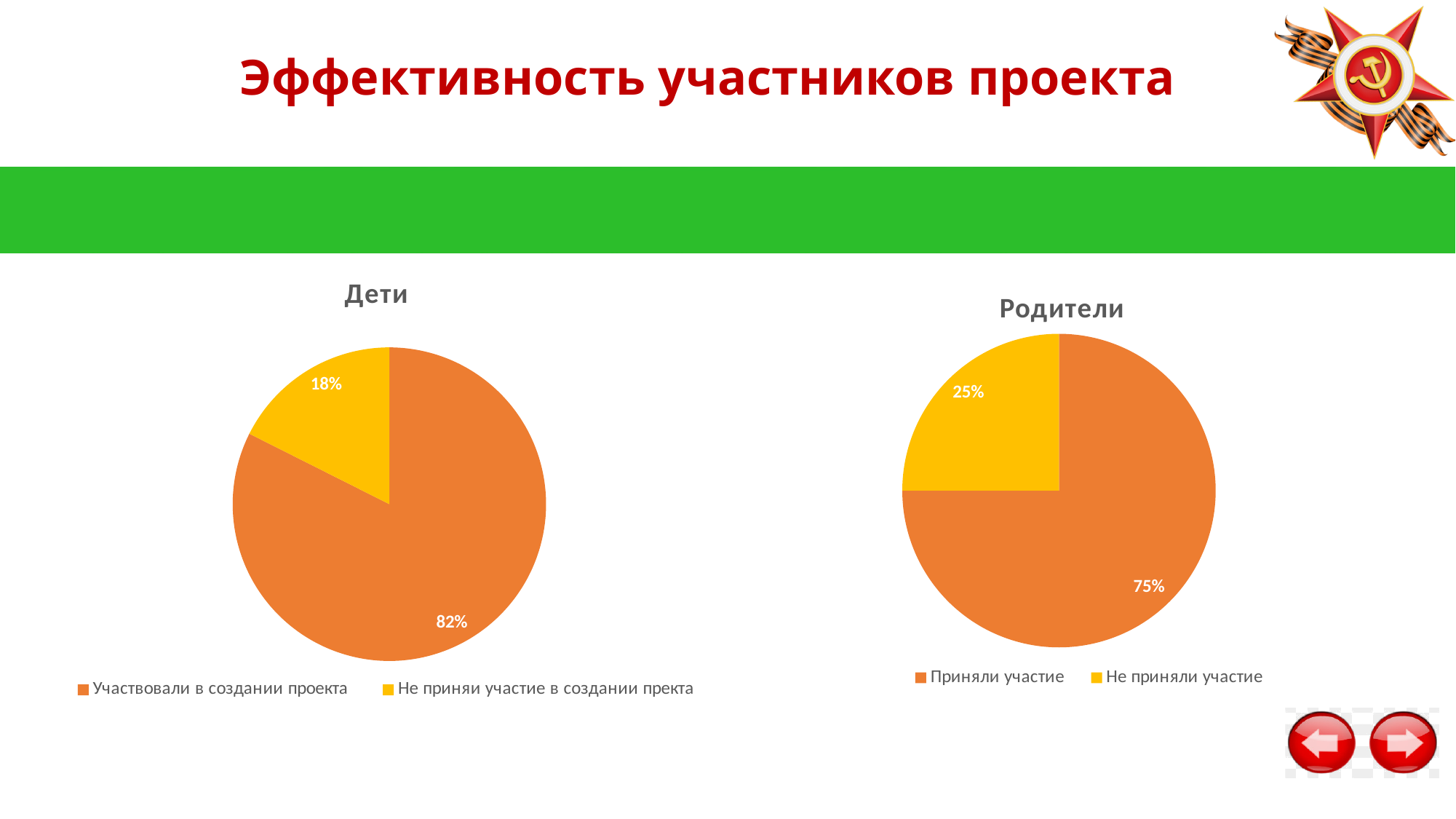
Which is larger: the 'Не приняи участие' slice in the 'Дети' chart or the 'Не приняли участие' slice in the 'Родители' chart? Родители (25%) In the 'Родители' chart, what share is labelled for 'Не приняли участие'? 25% In the 'Дети' chart, what share is labelled for 'Участвовали в создании проекта'? 82% How many entries does the legend of the 'Родители' chart list? 2 How many slices does the 'Дети' chart have? 2 In the 'Дети' chart, which slice is the largest? Участвовали в создании проекта In the 'Родители' chart, which slice is the smallest? Не приняли участие What type of chart is the 'Родители' chart? Pie chart In the 'Дети' chart, what share is labelled for 'Не приняи участие в создании пректа'? 18% In the 'Родители' chart, what is the difference between the two slices? 50% In the 'Родители' chart, what share is labelled for 'Приняли участие'? 75% In the 'Дети' chart, what is the difference between the two slices? 64%